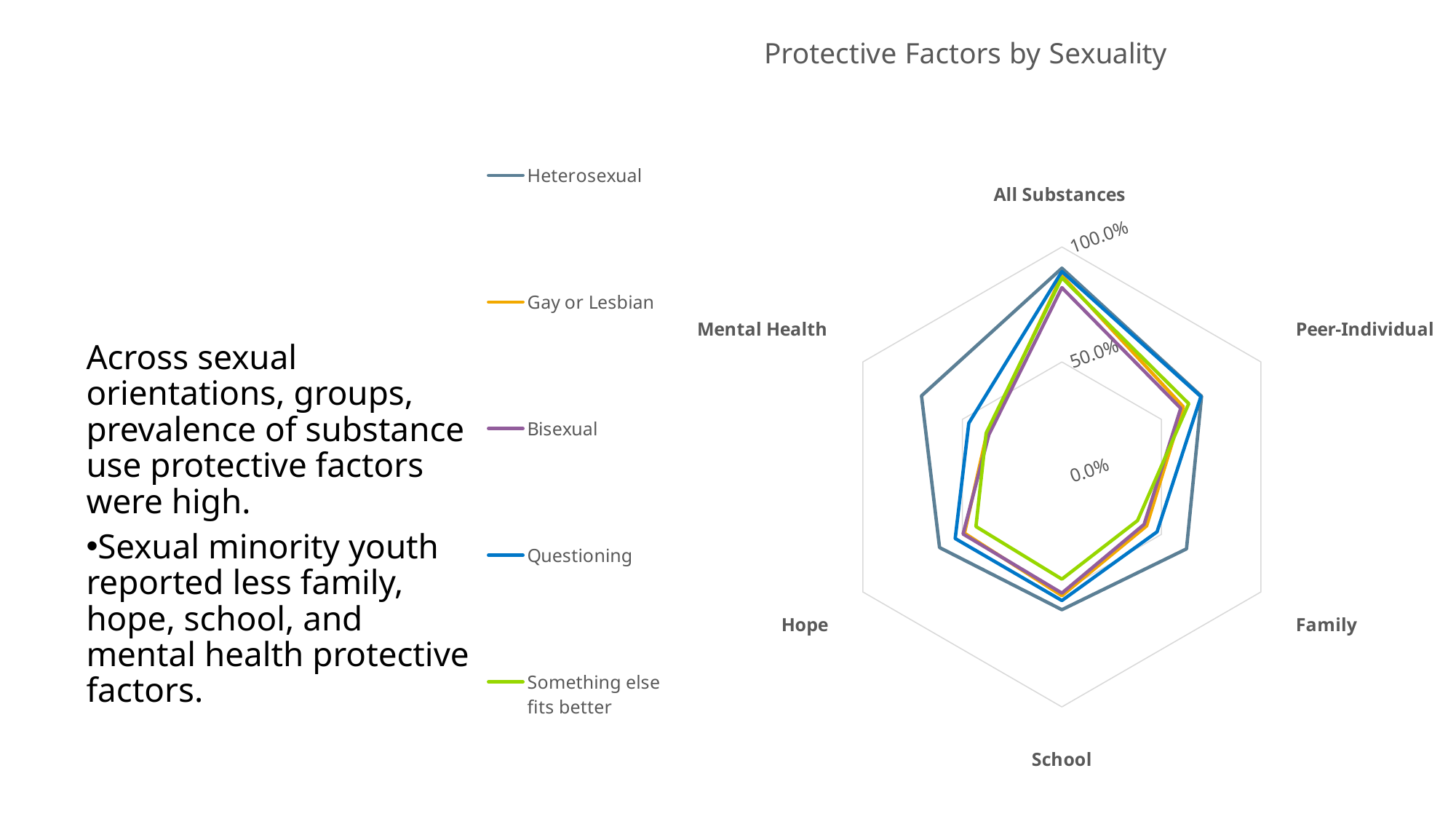
Which series has the highest value for Mental Health? Heterosexual What is the title of the chart? Protective Factors by Sexuality Is the Heterosexual value for All Substances greater or less than 50.0%? greater Is the Something else fits better value for Family greater or less than 50.0%? less How many protective factor categories are plotted on the chart? 6 Which series is plotted in green? Something else fits better What kind of chart is shown on the slide? Radar chart For the Heterosexual series, which category has the highest value? All Substances For Family, which is larger: the Heterosexual value or the Questioning value? Heterosexual Is the Bisexual value for Mental Health greater or less than 50.0%? less How many series does the legend list? 5